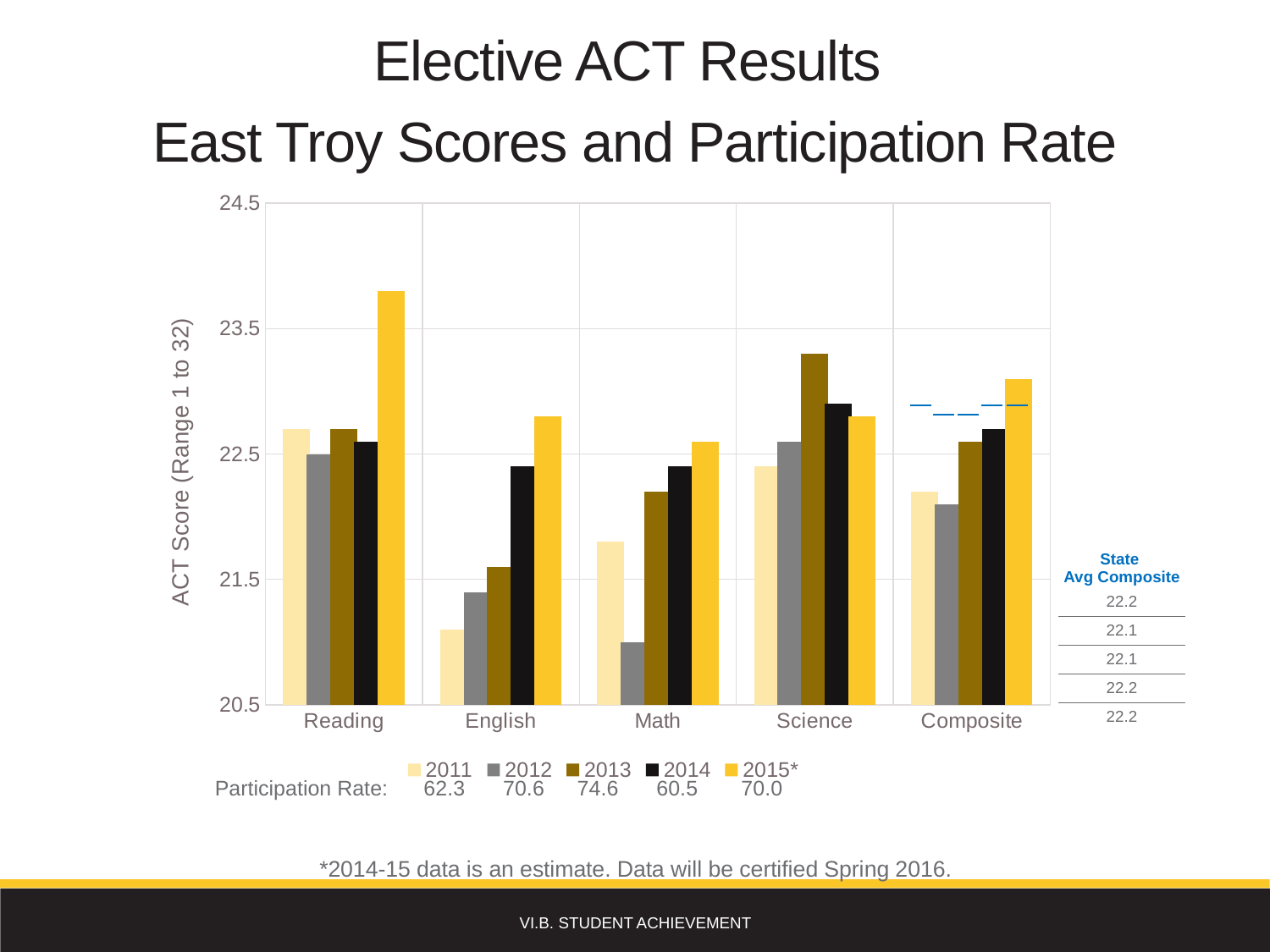
Which year has the highest bar in the Science category? 2013 How many series does the chart's legend list? 5 Is the Composite score for 2011 greater or less than 22.5? less What is the title of the chart's y axis? ACT Score (Range 1 to 32) Which year has the lowest bar in the Math category? 2012 Which category and year has the highest bar in the chart? Reading, 2015* Is the Reading score for 2015* greater or less than 23.5? greater Do the English scores rise or fall from 2011 to 2015*? rise Which is larger, the Science score for 2013 or the Science score for 2014? Science score for 2013 Is the English score for 2011 greater or less than 21.5? less What kind of chart is shown on the slide? bar chart How many categories are shown along the x axis of the chart? 5